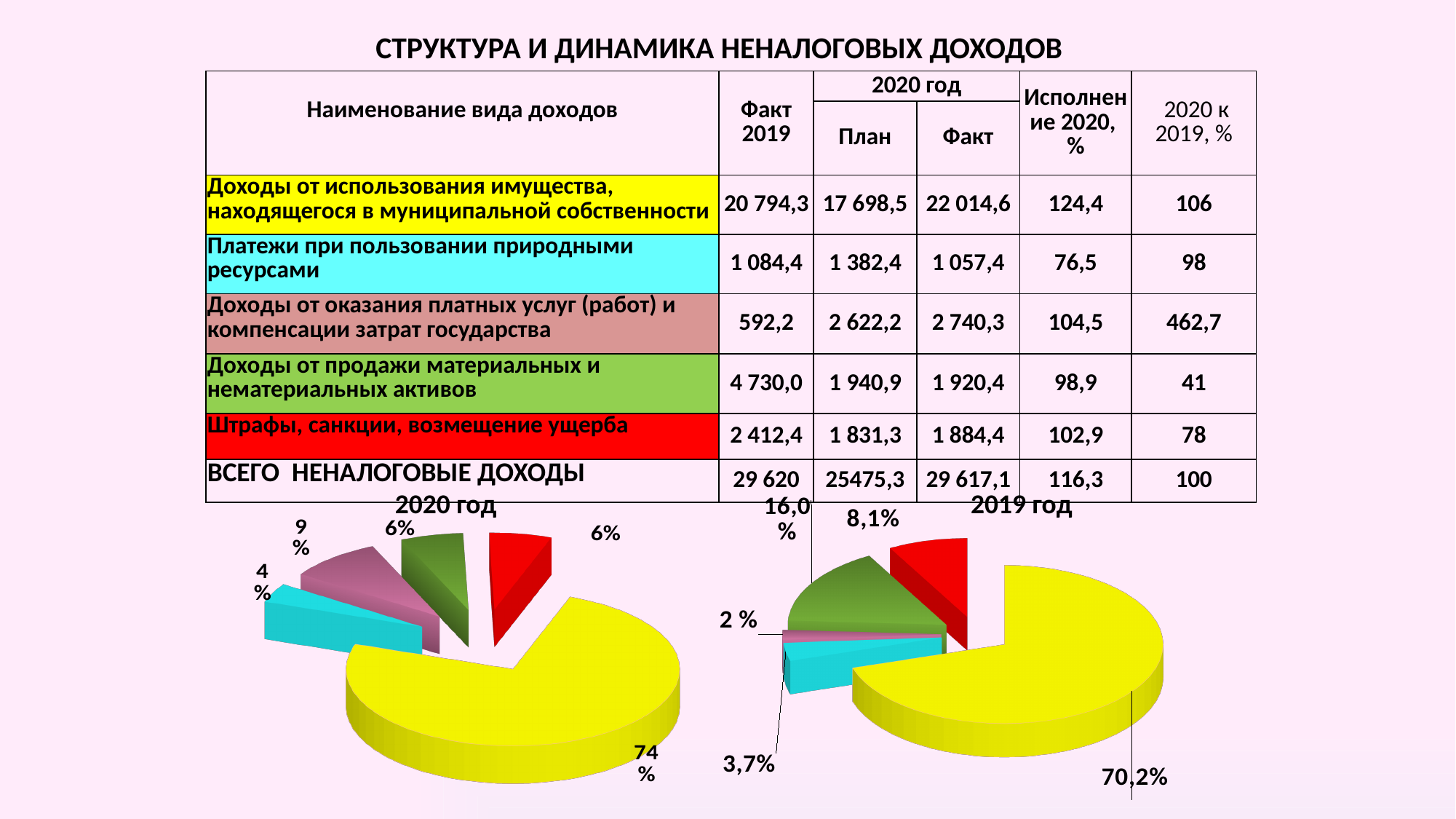
In the "2020 год" pie chart, what share does the largest (yellow) slice have? 74% In the "2020 год" pie chart, which colour slice is the smallest? Cyan (4%) In the "2019 год" pie chart, what share is labelled on the green slice? 16,0% What is the title of the left pie chart? 2020 год In the "2019 год" pie chart, which colour slice is the smallest? Pink (2 %) In the "2020 год" pie chart, how many slices are there? 5 In the "2019 год" pie chart, what share is labelled on the red slice? 8,1% What kind of charts are shown at the bottom of the slide? Pie charts Is the green slice larger in the "2020 год" chart or in the "2019 год" chart? 2019 год By how many percentage points does the yellow slice's share in the "2020 год" chart exceed its share in the "2019 год" chart? 3,8 In the "2019 год" pie chart, what share does the largest (yellow) slice have? 70,2% In the "2019 год" pie chart, how many slices are there? 5